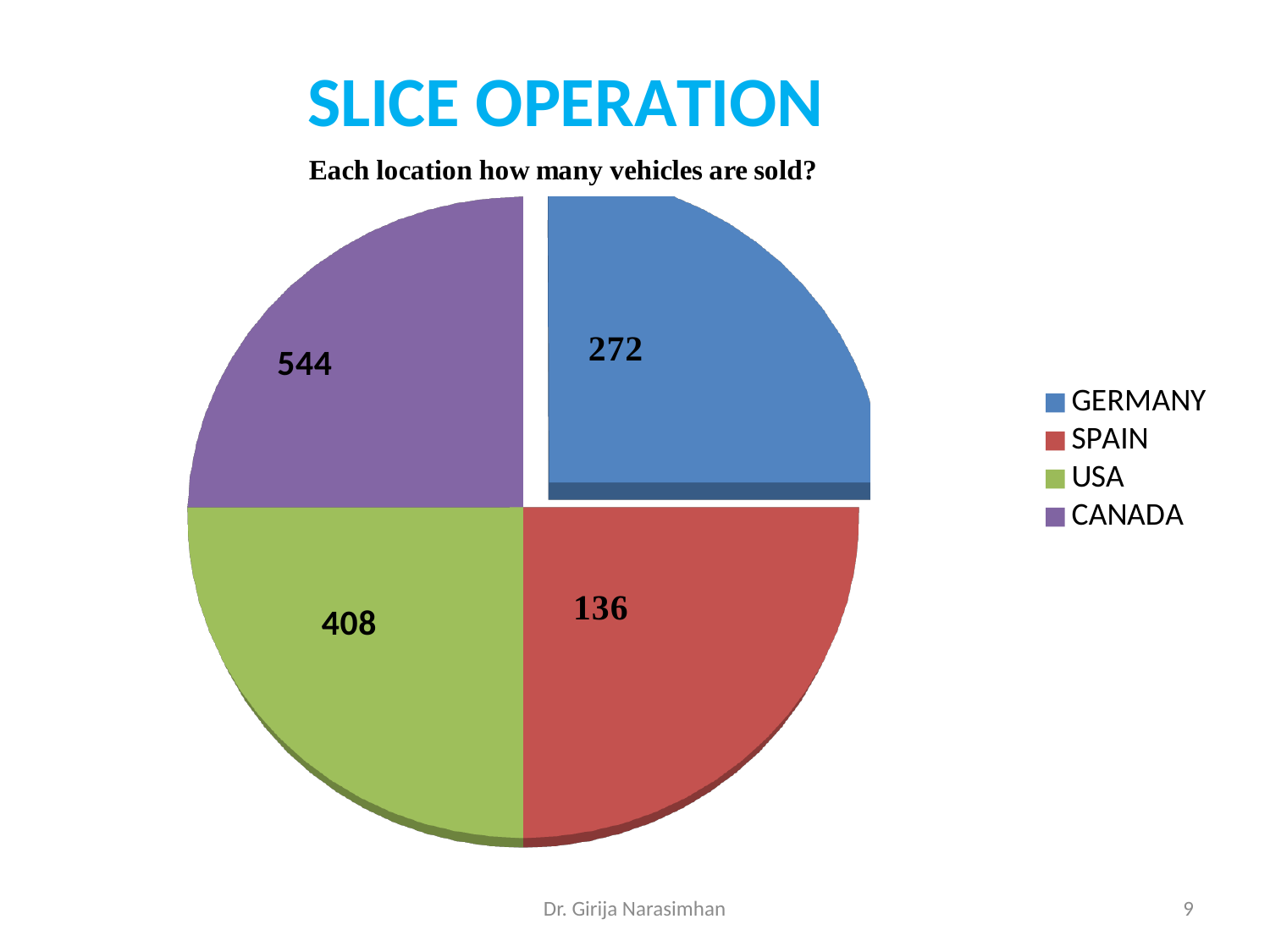
What value is shown for Canada on the pie chart? 544 Which has a larger value, USA or Germany? USA Which location has the highest number of vehicles sold? CANADA What value is shown for USA on the pie chart? 408 How many vehicles were sold in Germany according to the pie chart? 272 Which location has the lowest number of vehicles sold? SPAIN What value is shown for Spain on the pie chart? 136 What is the difference between the values for Canada and Spain? 408 How many locations are shown in the pie chart? 4 What type of chart is shown on the slide? Pie chart